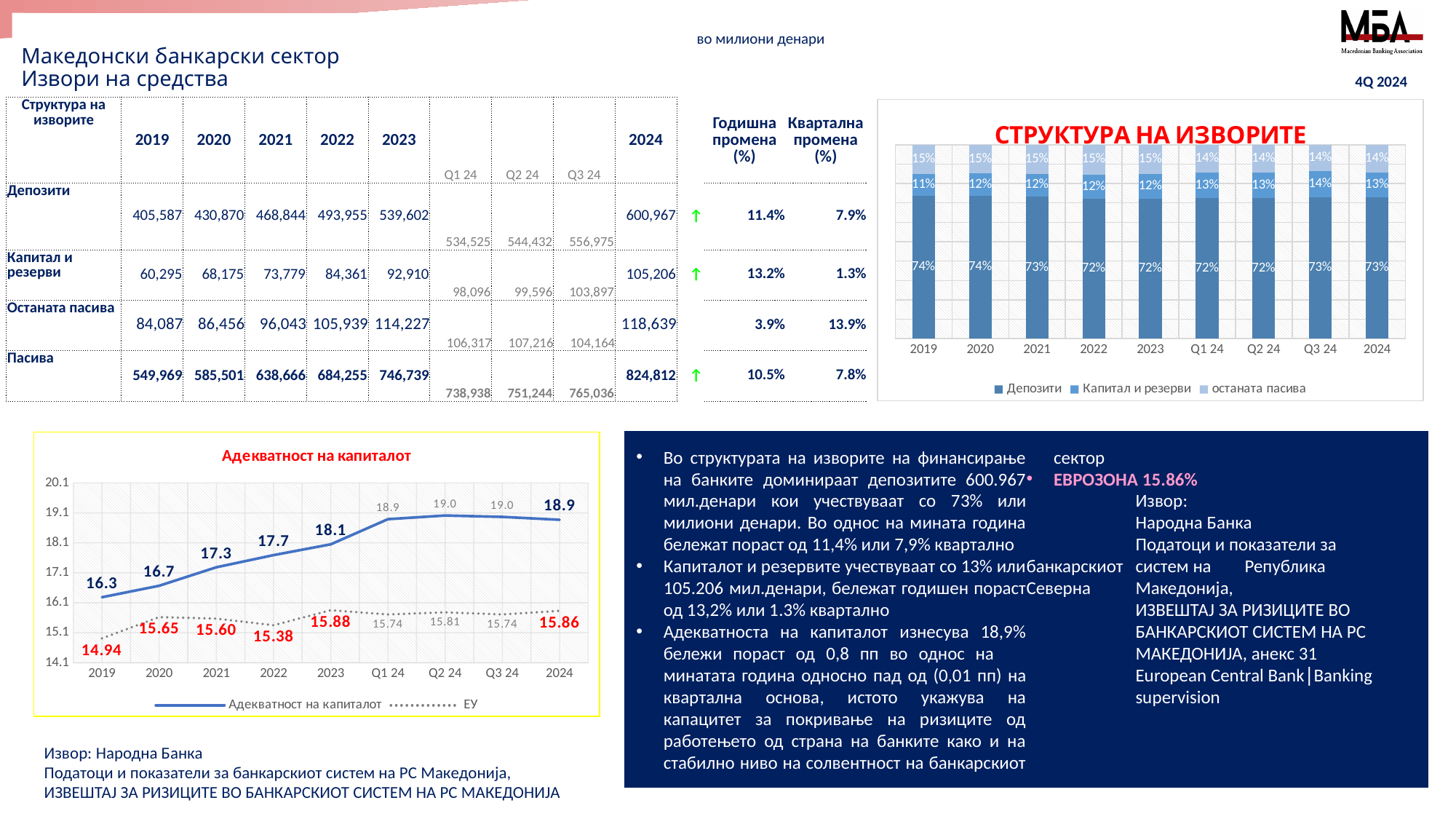
In the 'СТРУКТУРА НА ИЗВОРИТЕ' chart, what is the total of the stacked bar for 2024? 100% What kind of chart is the 'СТРУКТУРА НА ИЗВОРИТЕ' chart? Bar chart In the 'Адекватност на капиталот' chart, what is the difference between the Адекватност на капиталот values for 2024 and 2019? 2.6 In the 'Адекватност на капиталот' chart, what is the value of ЕУ in 2019? 14.94 In the 'СТРУКТУРА НА ИЗВОРИТЕ' chart, what is the share of Депозити in 2019? 74% How many categories are shown on the x axis of the 'СТРУКТУРА НА ИЗВОРИТЕ' chart? 9 In the 'Адекватност на капиталот' chart, which period has the lowest value for Адекватност на капиталот? 2019 In the 'СТРУКТУРА НА ИЗВОРИТЕ' chart, what is the share of Капитал и резерви in Q3 24? 14% How many series does the legend of the 'СТРУКТУРА НА ИЗВОРИТЕ' chart list? 3 In the 'Адекватност на капиталот' chart, what is the value of Адекватност на капиталот in 2023? 18.1 In the 'Адекватност на капиталот' chart, does the Адекватност на капиталот line rise or fall from 2019 to 2023? Rise In the 'Адекватност на капиталот' chart, which series has the larger value in 2024, Адекватност на капиталот or ЕУ? Адекватност на капиталот